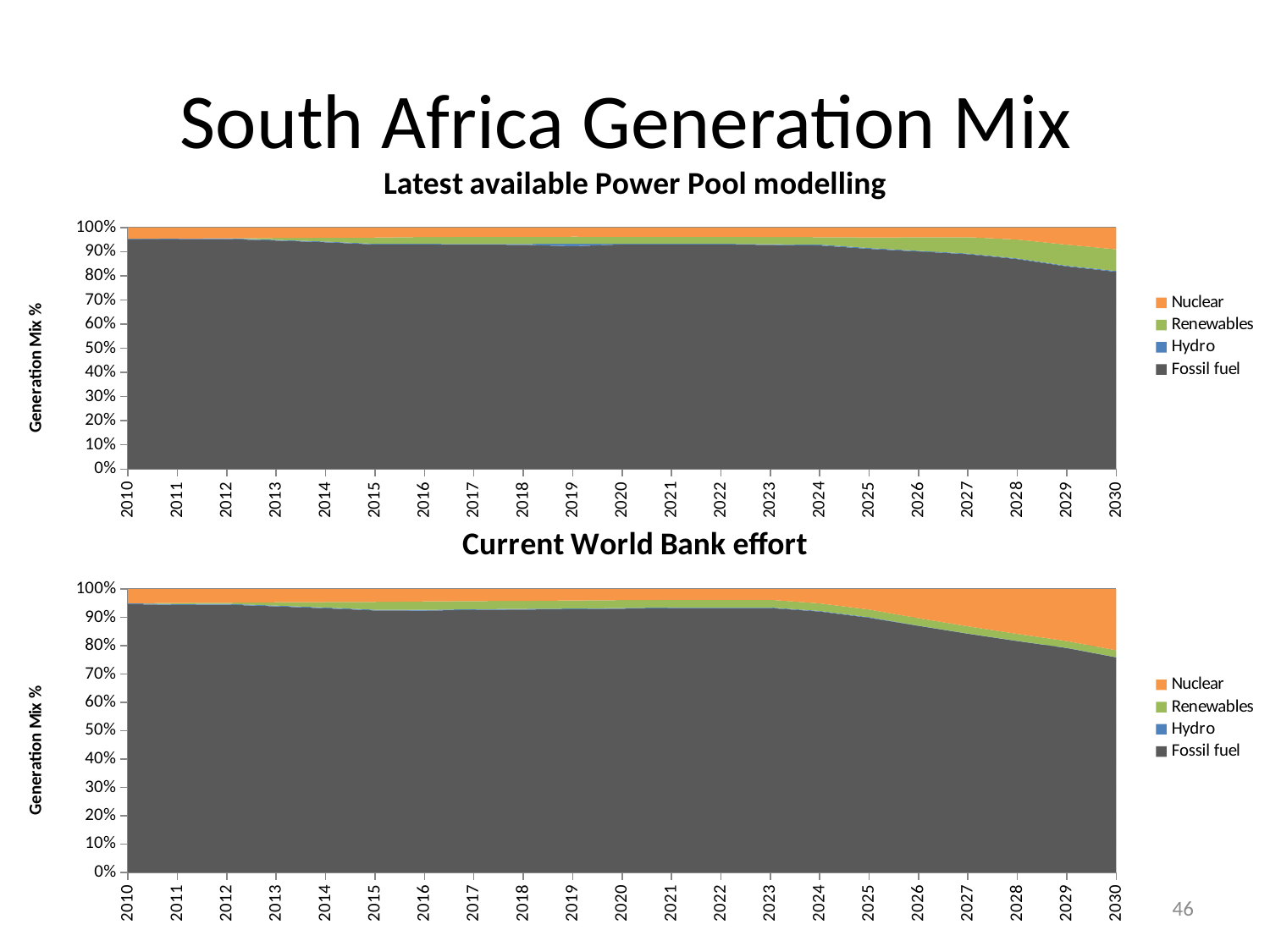
In the 'Current World Bank effort' chart, is the Fossil fuel share in 2030 greater or less than 70%? greater What is the y-axis title of the 'Current World Bank effort' chart? Generation Mix % What kind of chart is the 'Latest available Power Pool modelling' chart? Stacked area chart In the 'Current World Bank effort' chart, is the Fossil fuel share in 2010 greater or less than 90%? greater Which chart shows the larger Fossil fuel share in 2030, 'Latest available Power Pool modelling' or 'Current World Bank effort'? Latest available Power Pool modelling How many series does the legend of the 'Current World Bank effort' chart list? 4 In the 'Current World Bank effort' chart, does the Nuclear share rise or fall from 2023 to 2030? Rise In the 'Current World Bank effort' chart, is the Fossil fuel share in 2030 greater or less than 80%? less In the 'Current World Bank effort' chart, which is larger in 2030, the Nuclear share or the Renewables share? Nuclear In the 'Latest available Power Pool modelling' chart, does the Fossil fuel share rise or fall from 2010 to 2030? Fall How many years are shown on the x axis of the 'Latest available Power Pool modelling' chart? 21